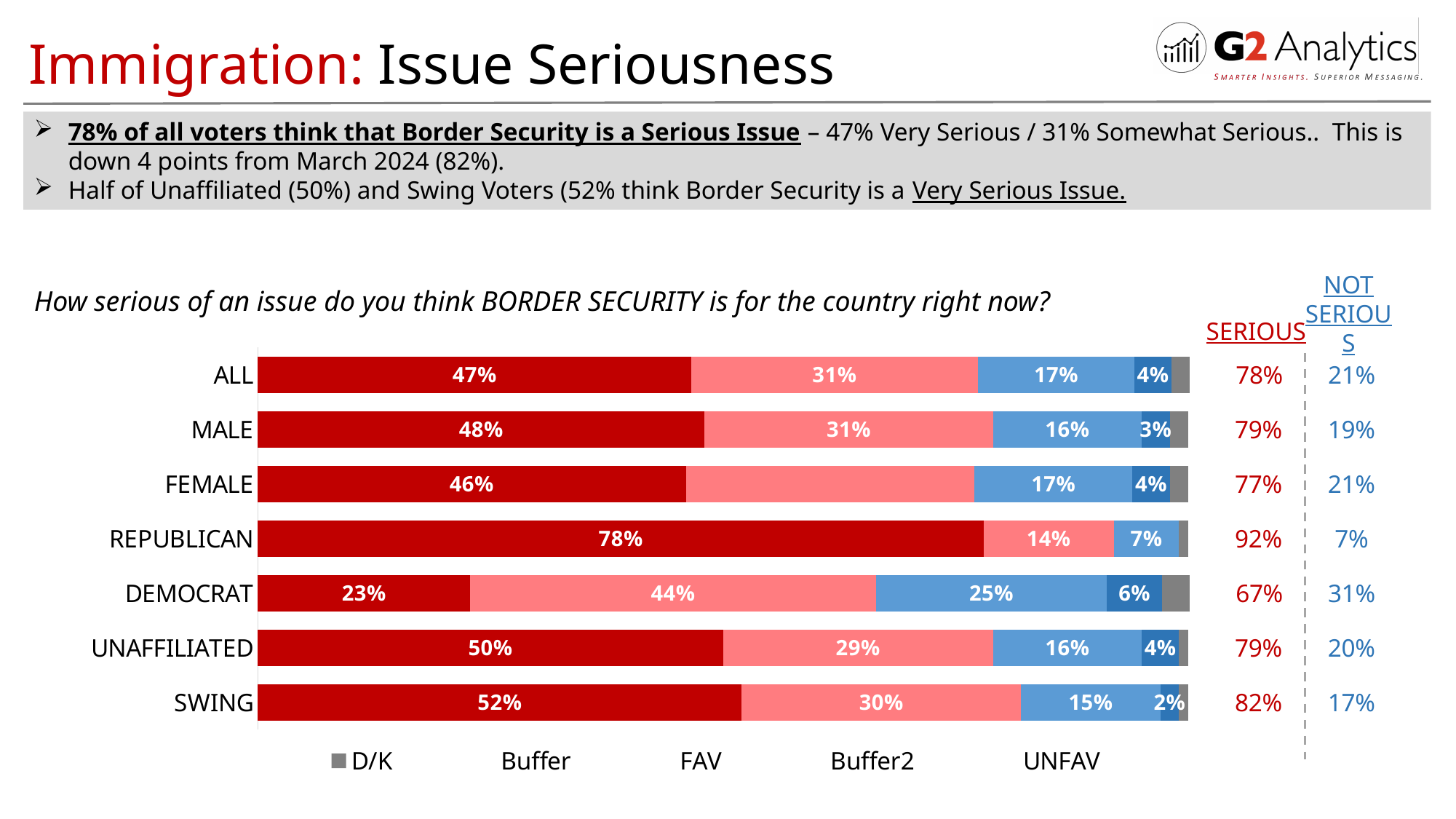
Which category has the smallest first (dark red) segment? DEMOCRAT How many categories (rows) does the bar chart show? 7 What is the SERIOUS value shown for DEMOCRAT to the right of the chart? 67% What is the value of the second (pink) segment for UNAFFILIATED? 29% What kind of chart is shown on the slide? Stacked bar chart What is the value of the first (dark red) segment for DEMOCRAT? 23% What is the value of the third (light blue) segment for SWING? 15% How many series does the chart legend list? 5 What is the value of the first (dark red) segment for REPUBLICAN? 78% Which is larger, the first (dark red) segment for MALE or for FEMALE? MALE Which category has the largest first (dark red) segment? REPUBLICAN What is the difference between the first (dark red) segment values for SWING and ALL? 5%